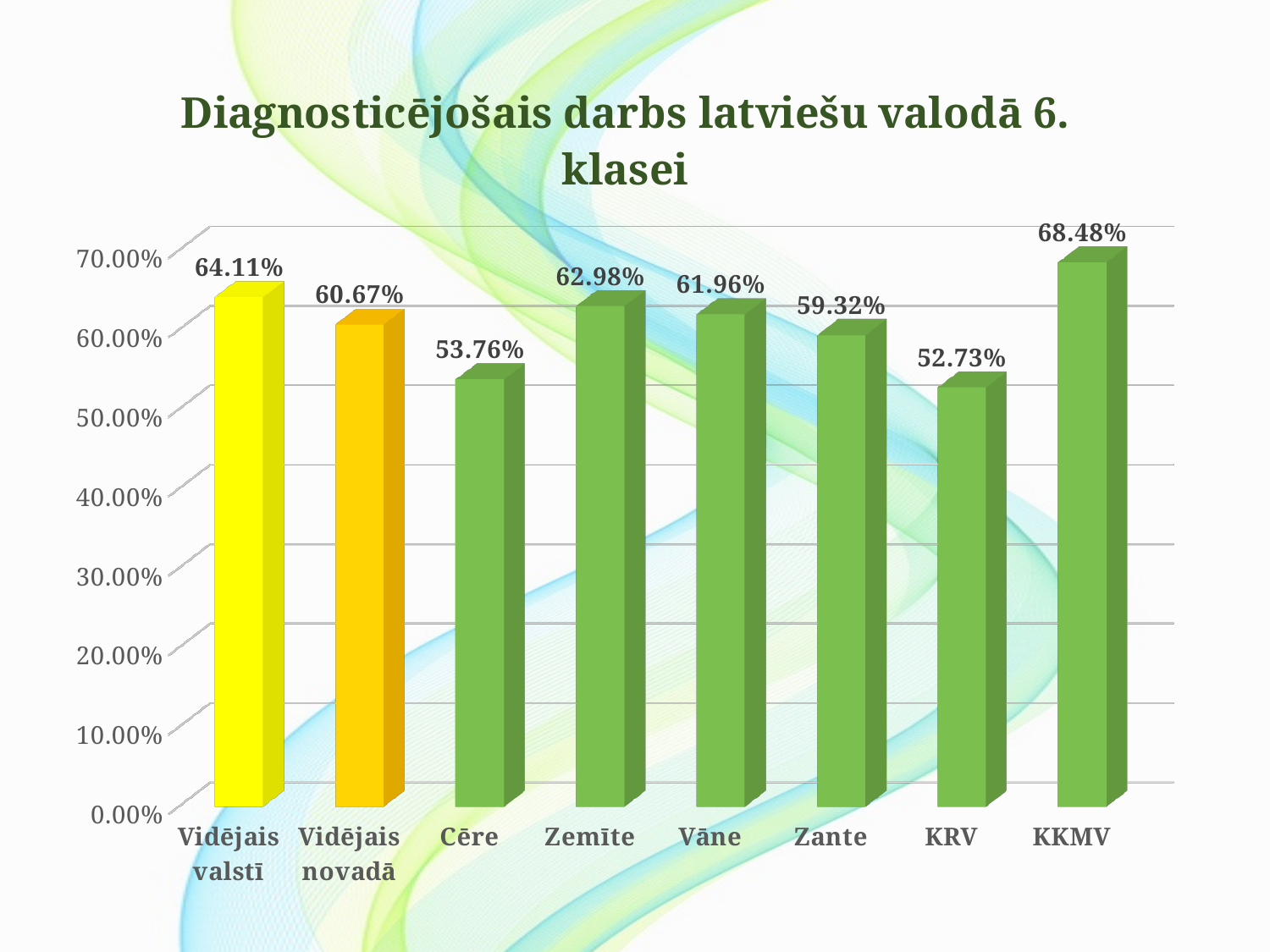
What is the value for Cēre? 53.76% Which category has the lowest value? KRV Is the value for Cēre greater or less than 60.00%? less Which category has the highest value? KKMV What is the value for Zante? 59.32% What is the difference between Vidējais valstī and Vidējais novadā? 3.44% What is the value for KKMV? 68.48% What kind of chart is shown on the slide? bar chart How many categories are shown on the x axis? 8 What is the value for Vidējais valstī? 64.11% What is the difference between the values for KKMV and KRV? 15.75% Which is larger, the value for Zemīte or the value for Vāne? Zemīte